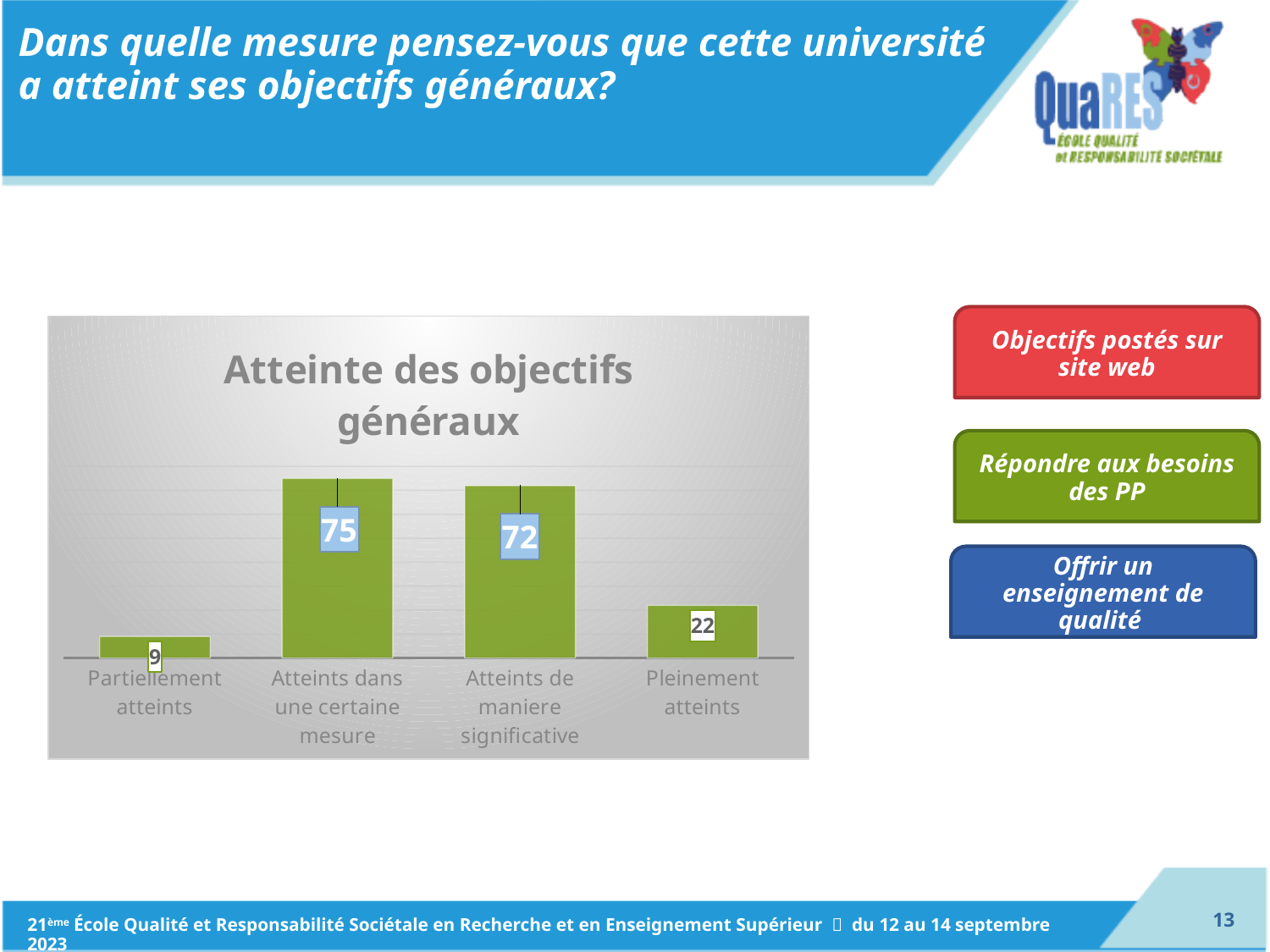
What is the difference between the values for "Pleinement atteints" and "Partiellement atteints"? 13 How many categories are shown in the chart? 4 What is the value for "Atteints de maniere significative"? 72 What is the difference between the values for "Atteints dans une certaine mesure" and "Atteints de maniere significative"? 3 What is the title of the chart? Atteinte des objectifs généraux Which category has the lowest value? Partiellement atteints Which category has the highest value? Atteints dans une certaine mesure What is the value for "Partiellement atteints"? 9 Which is larger, the value for "Pleinement atteints" or the value for "Partiellement atteints"? Pleinement atteints What is the value for "Atteints dans une certaine mesure"? 75 What kind of chart is shown on the slide? Bar chart What is the value for "Pleinement atteints"? 22